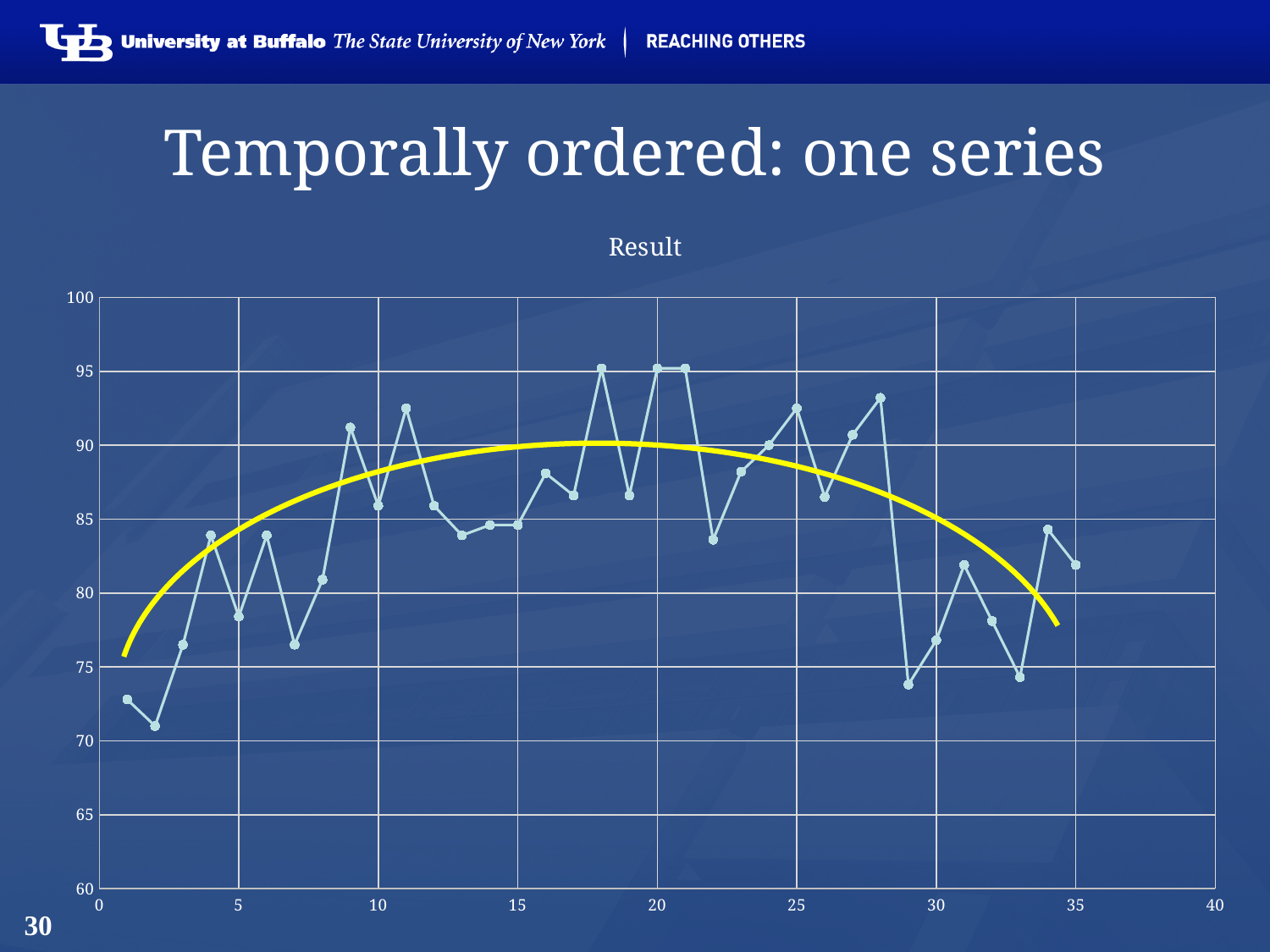
What kind of chart is shown on the slide? line chart Is the value at x = 28 greater or less than 90? greater Is the value at x = 20 greater or less than 90? greater Is the value at x = 2 greater or less than 75? less At which x value is the lowest point on the chart? 2 What colour is the smooth fitted curve drawn over the data points? yellow Do the values generally rise or fall from x = 1 to x = 4? rise What is the title of the chart? Result Which is larger, the value at x = 18 or the value at x = 19? x = 18 How many data points are plotted on the chart? 35